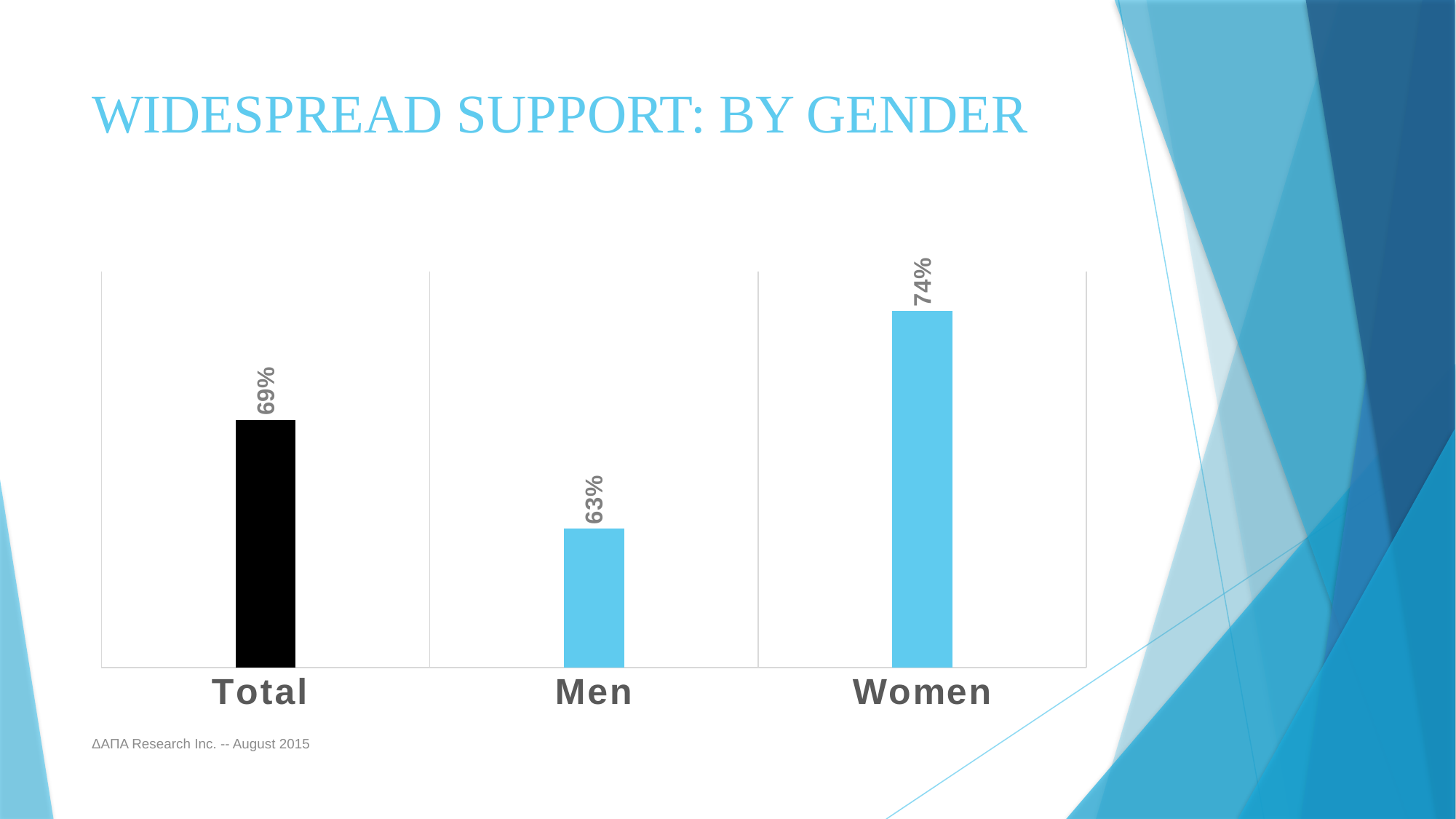
Which is larger, the value for Men or the value for Women? Women What is the difference between the values for Total and Men? 6% What is the value for Men? 63% What is the value for Women? 74% Which category has the lowest value? Men What kind of chart is shown on the slide? Bar chart Which bar is coloured black? Total What is the title of the slide? WIDESPREAD SUPPORT: BY GENDER Which category has the highest value? Women What is the value for Total? 69% What is the difference between the values for Women and Men? 11% How many categories are shown on the chart? 3